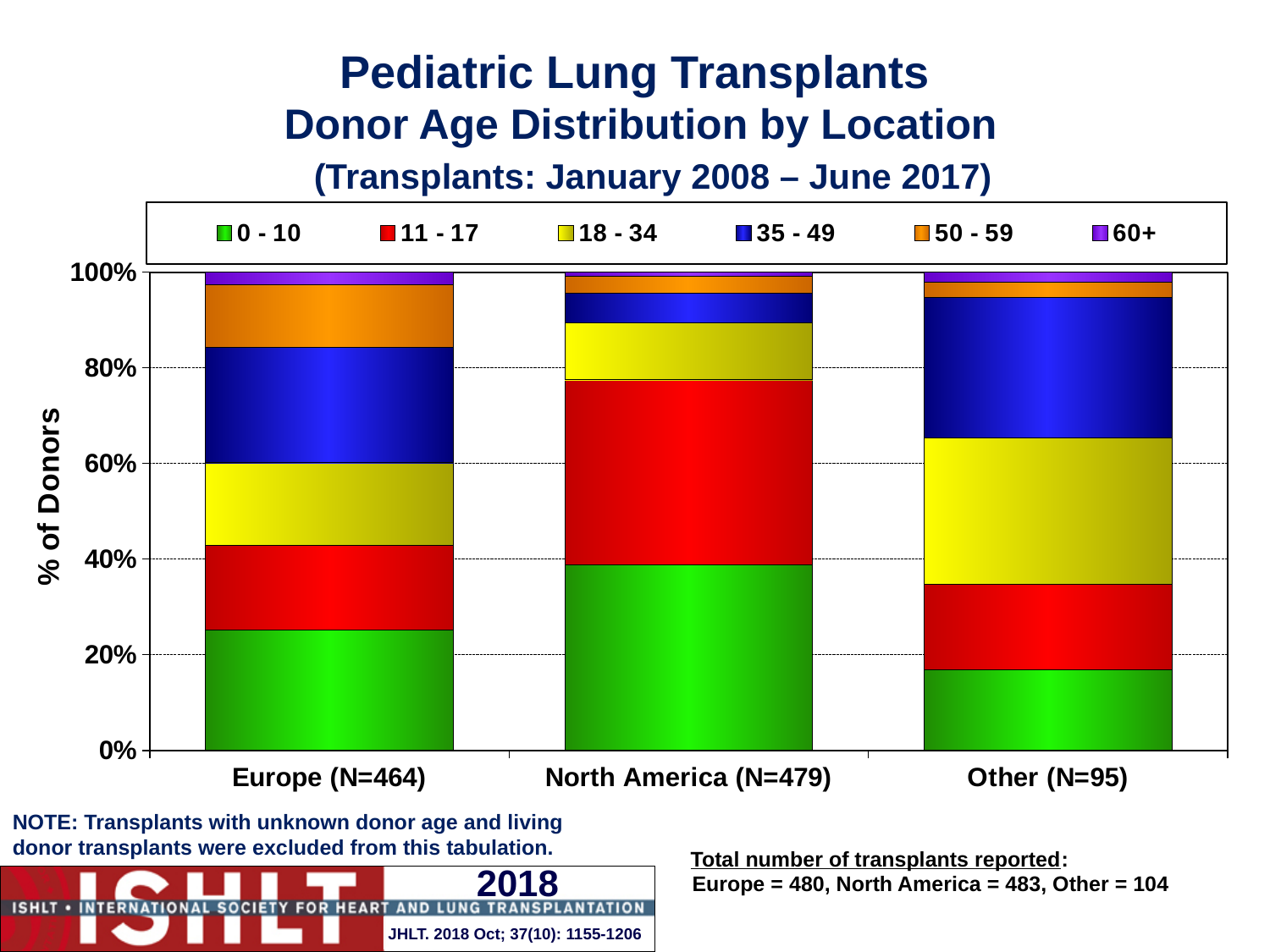
Which location has the largest share of donors aged 18 - 34? Other (N=95) Which location has the largest share of donors aged 35 - 49? Other (N=95) Which location has the largest share of donors aged 11 - 17? North America (N=479) How many locations (categories) are shown on the x axis? 3 How many donor age groups does the legend list? 6 What kind of chart is shown on the slide? Stacked bar chart What is the label on the y axis? % of Donors Is the share of donors aged 0 - 10 for North America greater or less than 20%? greater Which location has the smallest share of donors aged 0 - 10? Other (N=95) Which is larger: the share of donors aged 0 - 10 in Europe or in Other? Europe Is the share of donors aged 0 - 10 for Other greater or less than 20%? less